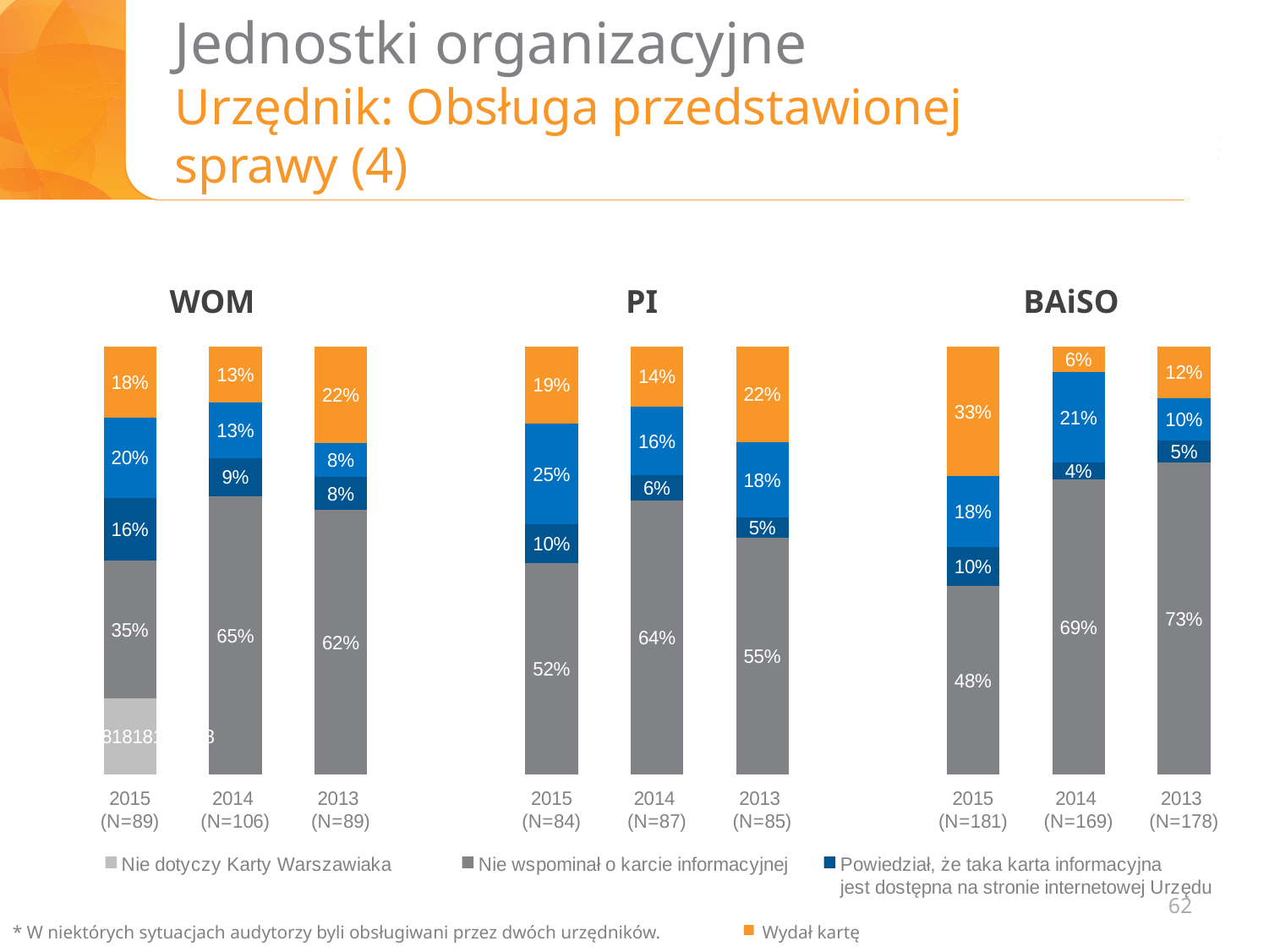
In the WOM chart, what is the difference between the 'Nie wspominał o karcie informacyjnej' values for 2014 and 2015? 30% In the BAiSO chart, which year has the highest value for 'Nie wspominał o karcie informacyjnej'? 2013 (N=178) In the PI chart, which is larger: the 'Wydał kartę' value for 2013 or for 2015? 2013 In the WOM chart, what is the value for 'Wydał kartę' in 2015 (N=89)? 18% In the BAiSO chart, what is the value for 'Wydał kartę' in 2015 (N=181)? 33% How many series does the legend at the bottom of the slide list? 4 How many bars does the BAiSO chart show? 3 What kind of chart is the PI chart? Stacked bar chart In the BAiSO chart, what is the value for 'Powiedział, że taka karta informacyjna jest dostępna na stronie internetowej Urzędu' in 2014 (N=169)? 4% In the PI chart, which year has the lowest value for 'Wydał kartę'? 2014 (N=87) In the BAiSO chart, does the 'Wydał kartę' value rise or fall from 2015 to 2014? Fall In the PI chart, what is the value for 'Nie wspominał o karcie informacyjnej' in 2014 (N=87)? 64%